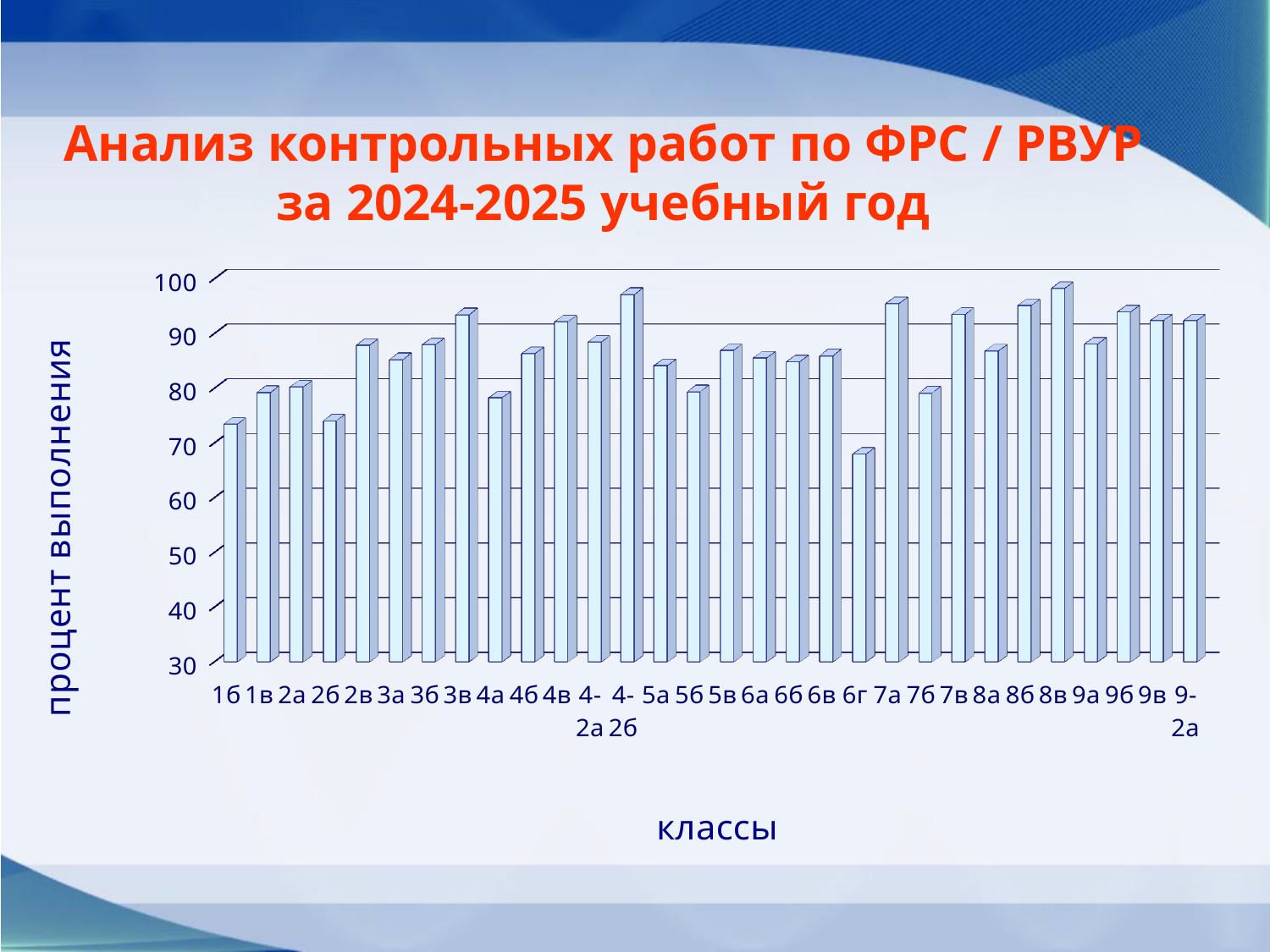
Which class has the lowest percentage of completion? 6г What is the label of the horizontal axis? классы Is the value for 2б greater or less than 80? less Is the value for 7а greater or less than 90? greater What is the label of the vertical axis? процент выполнения Which has the larger value, 2б or 2в? 2в Is the value for 1б greater or less than 80? less What kind of chart is shown on the slide? bar chart How many classes (categories) are plotted on the x axis? 30 Which has the larger value, 6г or 7а? 7а